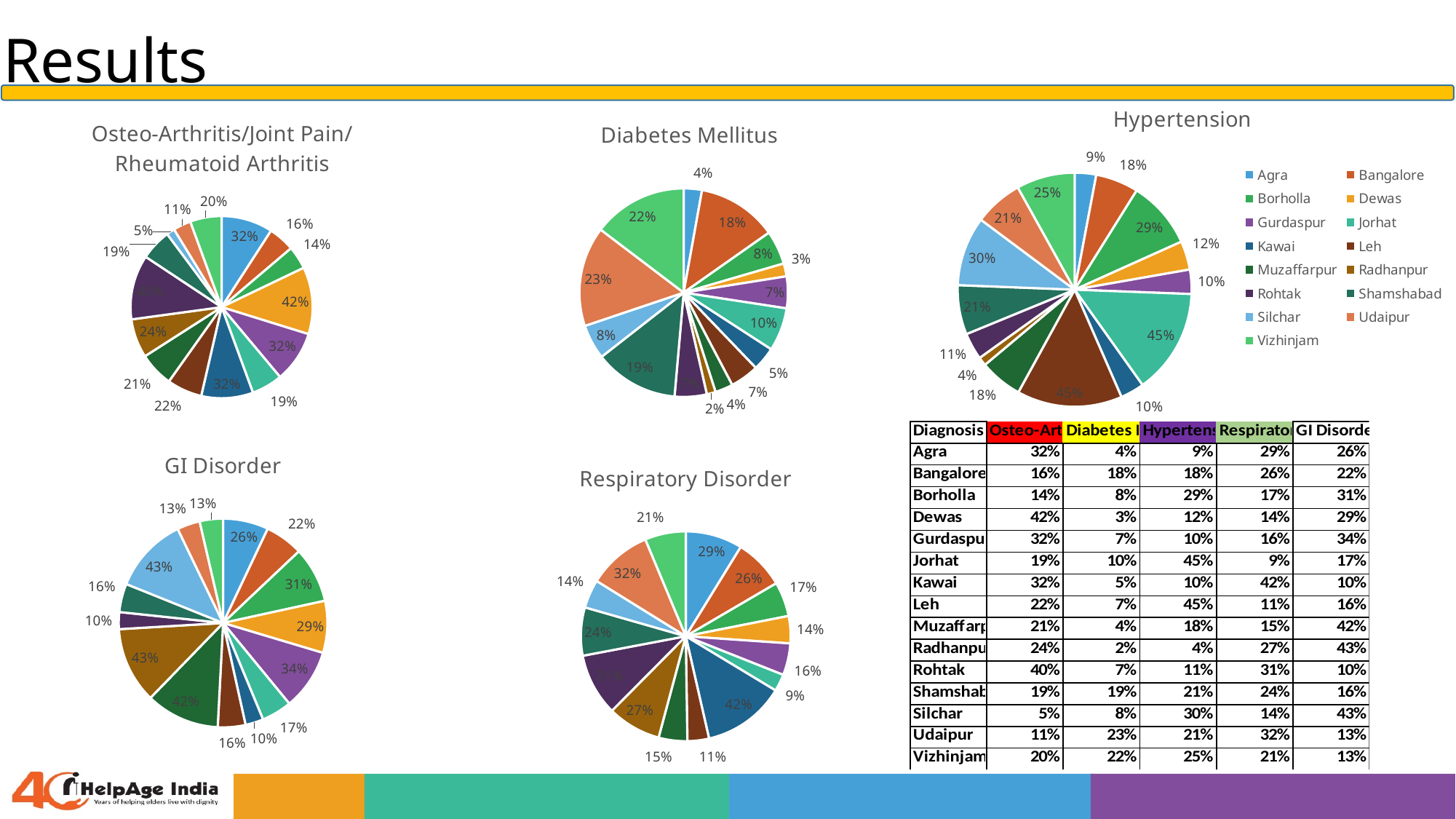
On the Diabetes Mellitus pie chart, what percentage is shown for Udaipur? 23% On the Osteo-Arthritis/Joint Pain/Rheumatoid Arthritis pie chart, which city has the largest slice? Dewas On the Respiratory Disorder pie chart, what percentage is shown for Kawai? 42% On the Respiratory Disorder pie chart, which is larger, the slice for Kawai or the slice for Udaipur? Kawai On the Hypertension pie chart, which city has the smallest slice? Radhanpur On the Diabetes Mellitus pie chart, what is the difference in percentage points between Udaipur and Agra? 19 percentage points How many pie charts are shown on the slide? 5 On the Diabetes Mellitus pie chart, which city has the smallest slice? Radhanpur How many cities does the legend next to the Hypertension chart list? 15 On the Diabetes Mellitus pie chart, which city has the largest slice? Udaipur On the Hypertension pie chart, what percentage is shown for Jorhat? 45% What type of chart is used for GI Disorder? Pie chart